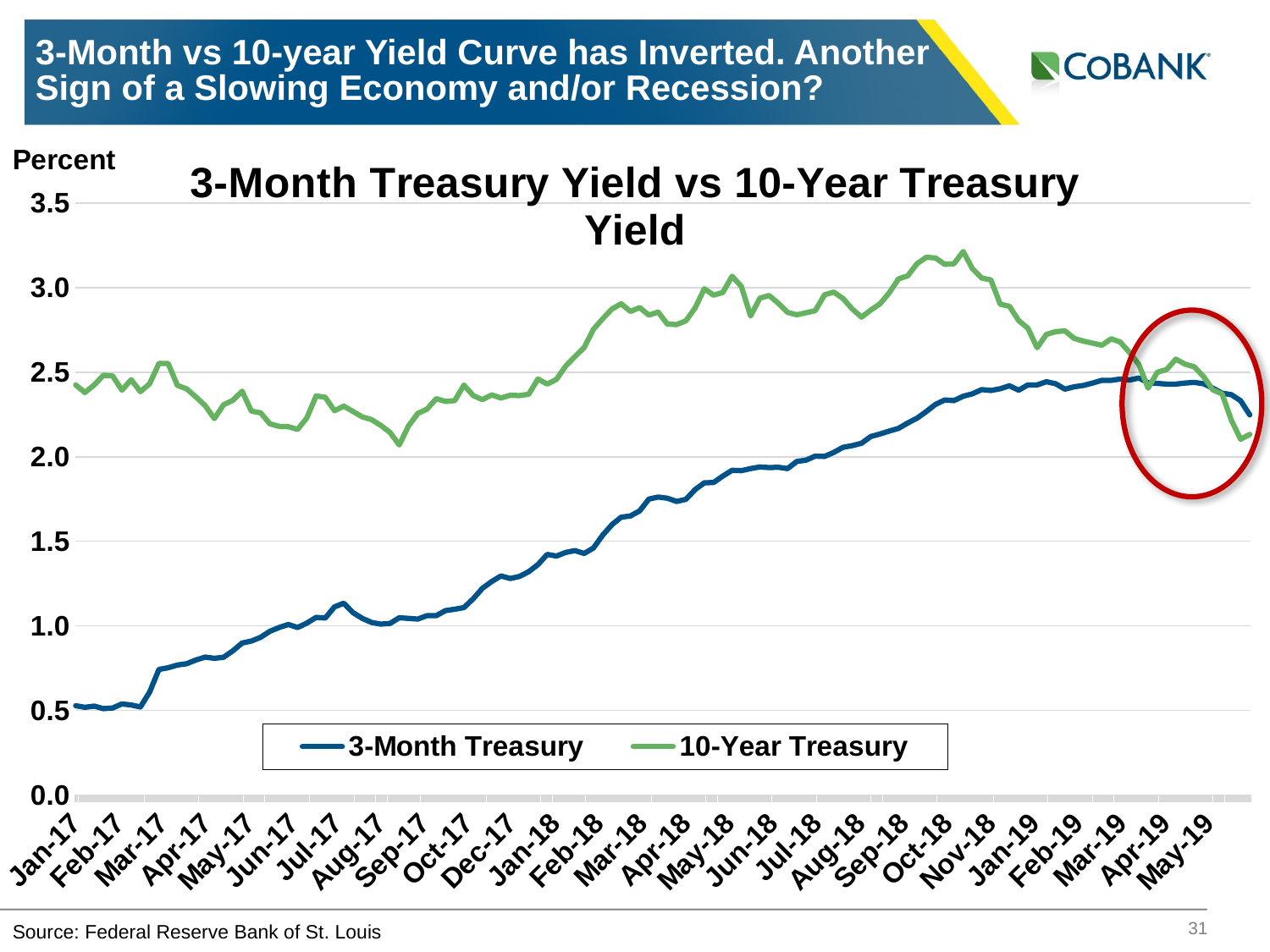
In Jan-17, which series has the higher yield, 3-Month Treasury or 10-Year Treasury? 10-Year Treasury What is the title of the chart? 3-Month Treasury Yield vs 10-Year Treasury Yield Does the 3-Month Treasury yield generally rise or fall from Jan-17 to Jan-19? rise Is the 10-Year Treasury yield in Oct-18 greater or less than 3.0? greater Which series has the lowest value anywhere on the chart? 3-Month Treasury What kind of chart is shown on the slide? line chart How many series does the legend list? 2 Is the 3-Month Treasury yield in Jan-19 greater or less than 2.0? greater Which series is drawn in green? 10-Year Treasury Which series reaches the highest value anywhere on the chart? 10-Year Treasury Is the 3-Month Treasury yield in Jan-17 greater or less than 1.0? less